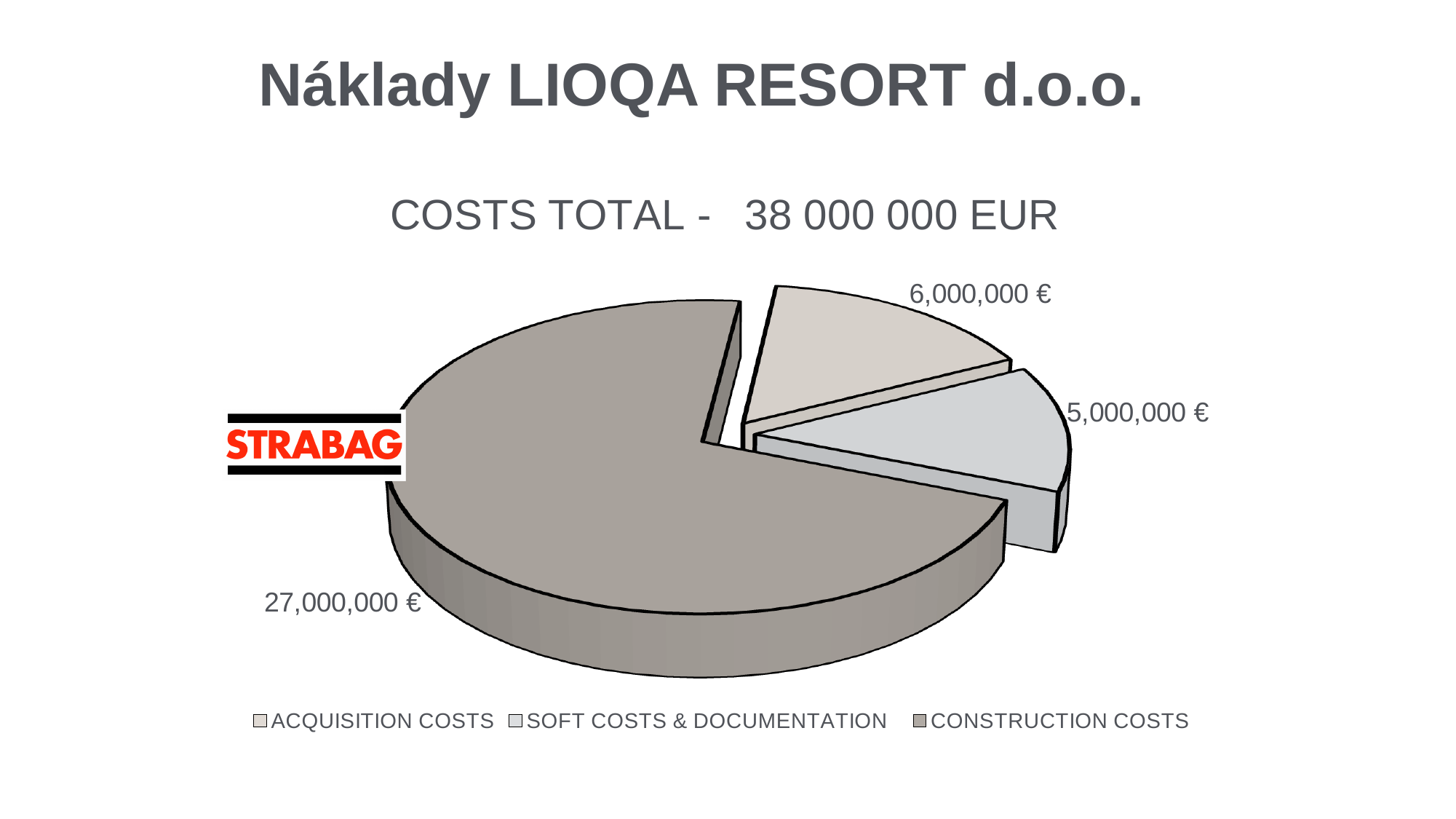
Which category has the smallest slice of the pie? Soft Costs & Documentation What is the total of all three slices in the pie chart? 38,000,000 € How many slices does the pie chart have? 3 What is the difference between Acquisition Costs and Soft Costs & Documentation? 1,000,000 € Which category has the largest slice of the pie? Construction Costs What is the title of the chart? COSTS TOTAL - 38 000 000 EUR What is the difference between Construction Costs and Acquisition Costs? 21,000,000 € Which is larger, Acquisition Costs or Soft Costs & Documentation? Acquisition Costs What is the value of the Construction Costs slice? 27,000,000 € What is the value of the Acquisition Costs slice? 6,000,000 € What is the value of the Soft Costs & Documentation slice? 5,000,000 € What kind of chart is shown on the slide? Pie chart